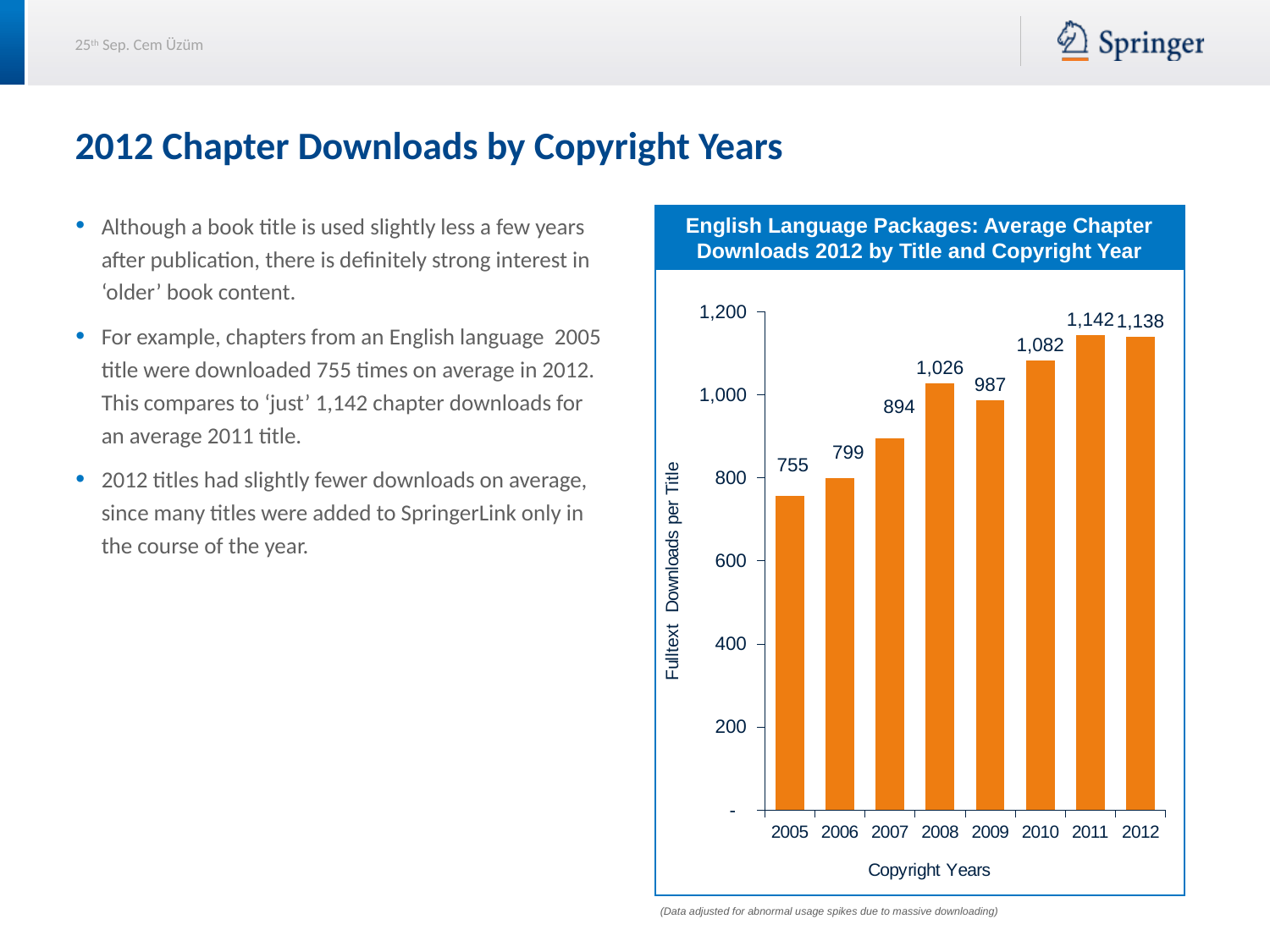
What type of chart is shown on the slide? bar chart Which copyright year has the highest average chapter downloads per title? 2011 What is the average number of fulltext downloads per title for copyright year 2005? 755 Which copyright year has the lowest average chapter downloads per title? 2005 Is the value for 2007 greater or less than 1,000? less What is the difference between the values for 2011 and 2005? 387 What is the value shown for copyright year 2012? 1,138 Which copyright year has the larger value, 2008 or 2009? 2008 What is the difference between the values for 2008 and 2009? 39 What is the value shown for copyright year 2008? 1,026 What is the label of the y axis? Fulltext Downloads per Title How many copyright years are shown on the x axis? 8